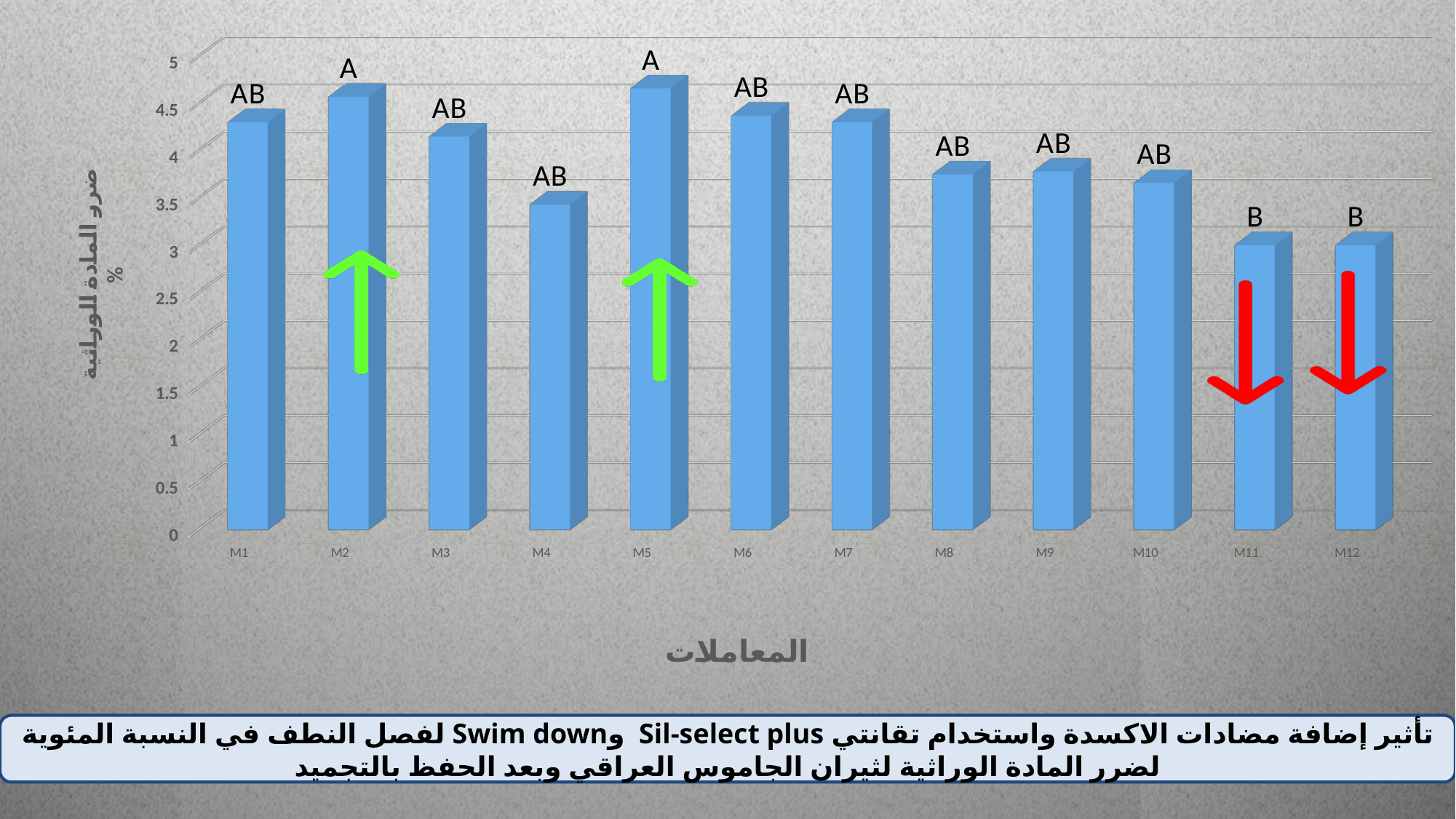
Is the value for M11 greater or less than 3.5? less Is the value for M5 greater or less than 4.5? greater Is the value for M4 greater or less than 4? less Which has the larger value, M8 or M12? M8 Which has the larger value, M2 or M4? M2 Which has the larger value, M5 or M11? M5 What kind of chart is shown on the slide? bar chart What letter label is printed above the bar for M2? A What letter label is printed above the bar for M11? B How many categories (M1 to M12) are plotted on the x axis? 12